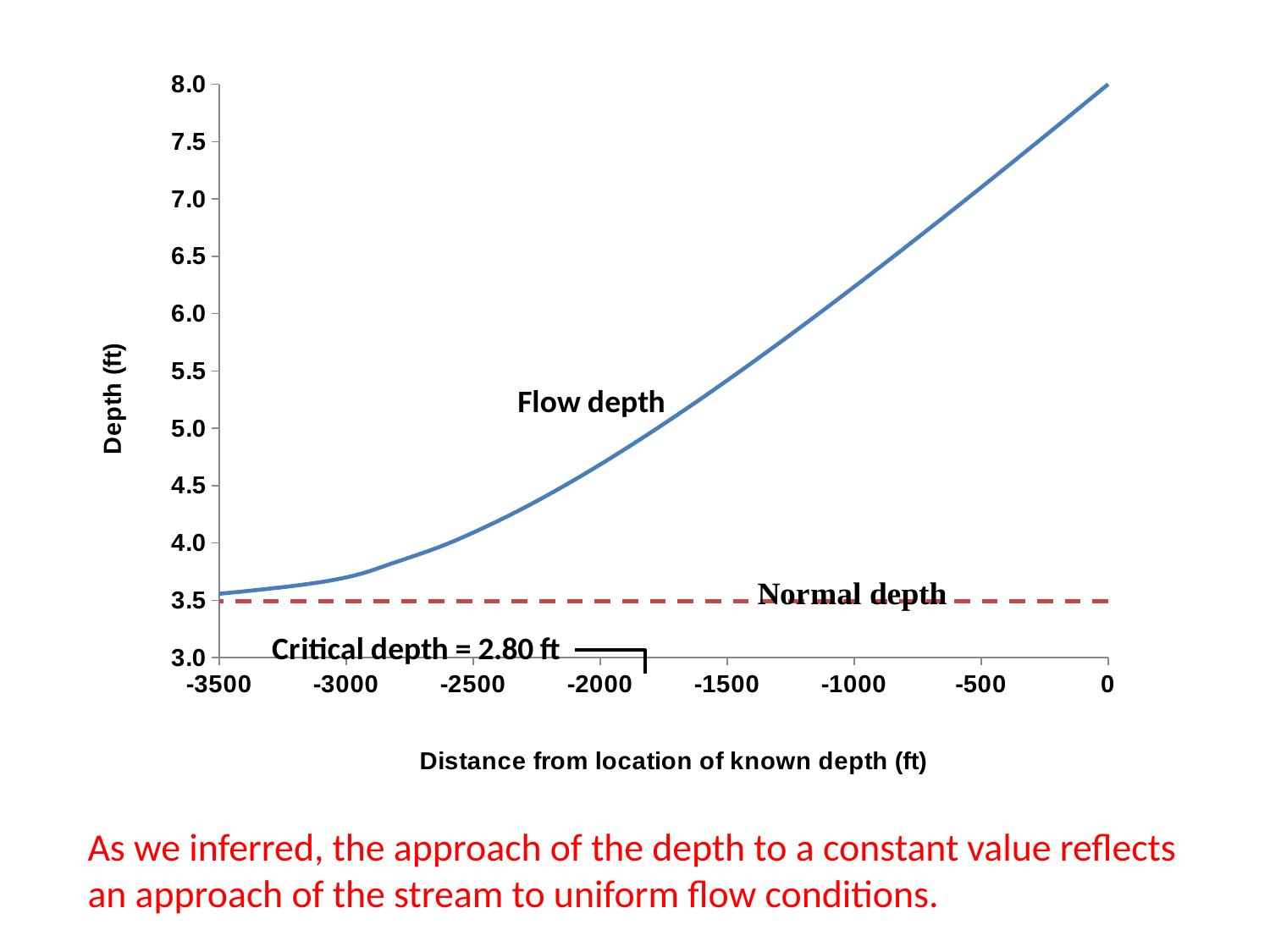
At which distance is the flow depth lowest? -3500 What is the flow depth at a distance of 0 ft? 8.0 Is the flow depth at a distance of -3000 ft greater or less than 3.5? greater What kind of chart is shown on the slide? line chart What does the dashed red line represent? Normal depth Is the flow depth at a distance of -1500 ft greater or less than 5.0? greater What is the title of the x axis? Distance from location of known depth (ft) At which distance is the flow depth highest? 0 At a distance of -1000 ft, which is larger: the flow depth or the normal depth? Flow depth Does the flow depth rise or fall as the distance goes from -3500 toward 0? rise What is the critical depth stated on the chart? 2.80 ft Is the flow depth at a distance of -2000 ft greater or less than 4.5? greater